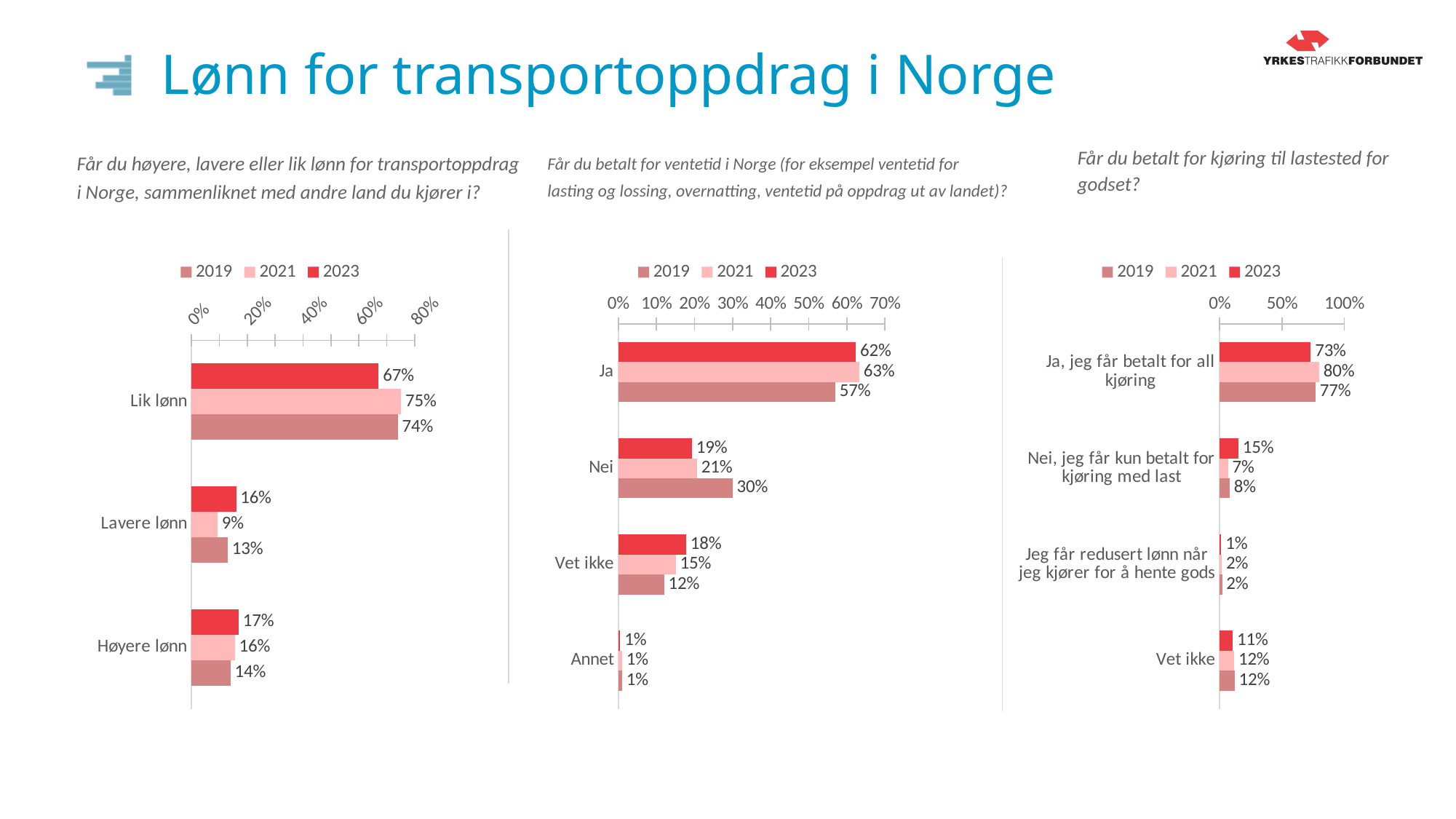
How many series does the legend of the left chart list? 3 In the right chart, what is the 2021 value for 'Ja, jeg får betalt for all kjøring'? 80% In the middle chart, which category has the lowest 2019 value? Annet In the middle chart, what is the 2019 value for Nei? 30% In the middle chart, which category has the highest 2023 value? Ja In the left chart, what is the 2023 value for Lavere lønn? 16% In the left chart, what is the difference between the 2021 and 2023 values for Lik lønn? 8% What type of chart is the middle chart? Bar chart In the left chart, what is the 2021 value for Lik lønn? 75% In the middle chart, how many categories are shown? 4 In the right chart, what is the difference between the 2023 and 2021 values for 'Nei, jeg får kun betalt for kjøring med last'? 8% In the right chart, is the 2023 value for 'Nei, jeg får kun betalt for kjøring med last' larger or smaller than the 2019 value? larger